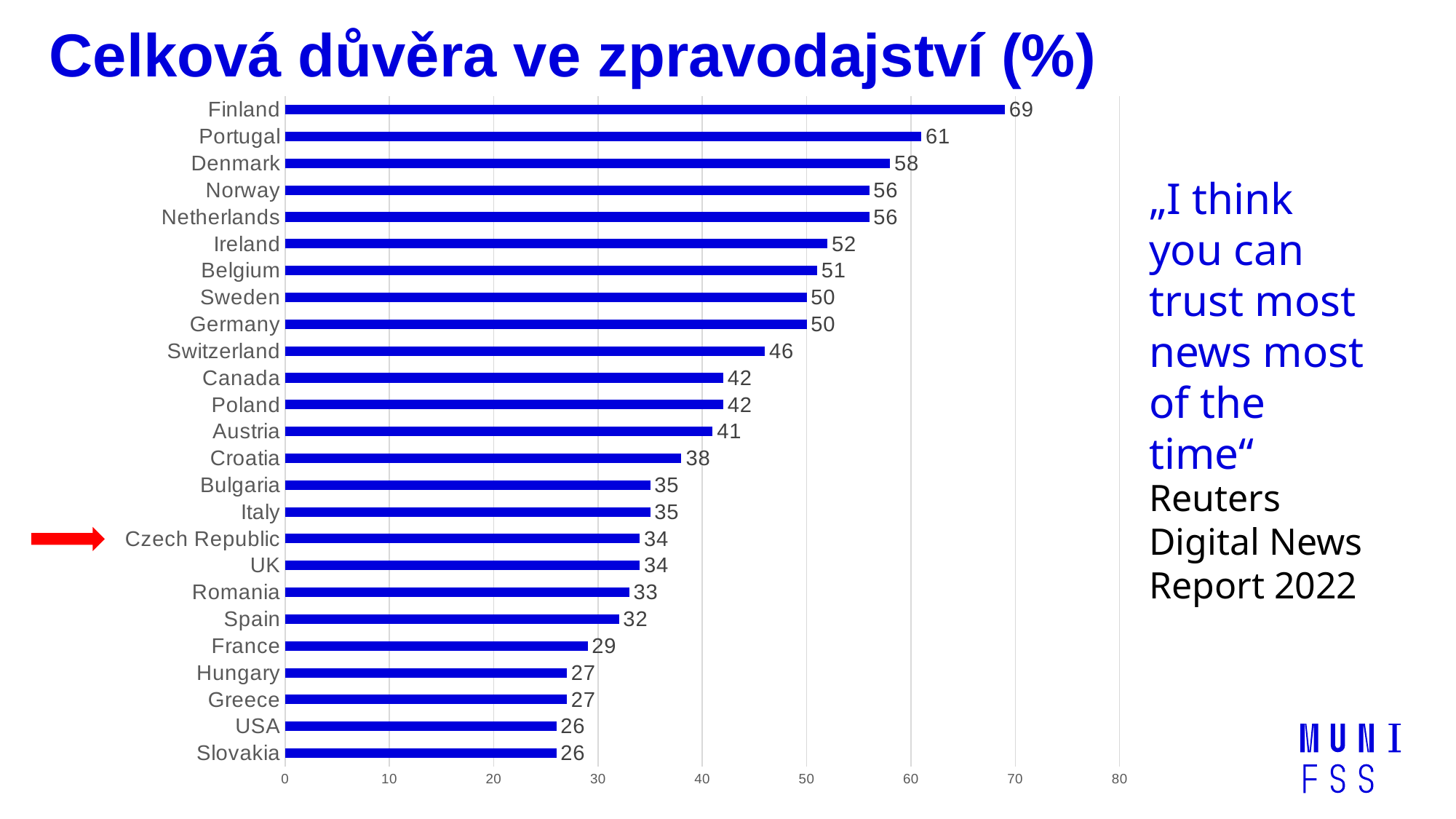
Which has a larger value, Ireland or Croatia? Ireland What is the title of the slide? Celková důvěra ve zpravodajství (%) Which has a larger value, Hungary or Spain? Spain Which country has the highest value? Finland What is the value for the Czech Republic? 34 What is the difference between the values for Finland and Portugal? 8 What is the value for France? 29 What kind of chart is shown on the slide? bar chart What is the value for Finland? 69 How many countries are shown in the chart? 25 What is the difference between the values for Denmark and Slovakia? 32 What is the value for Germany? 50